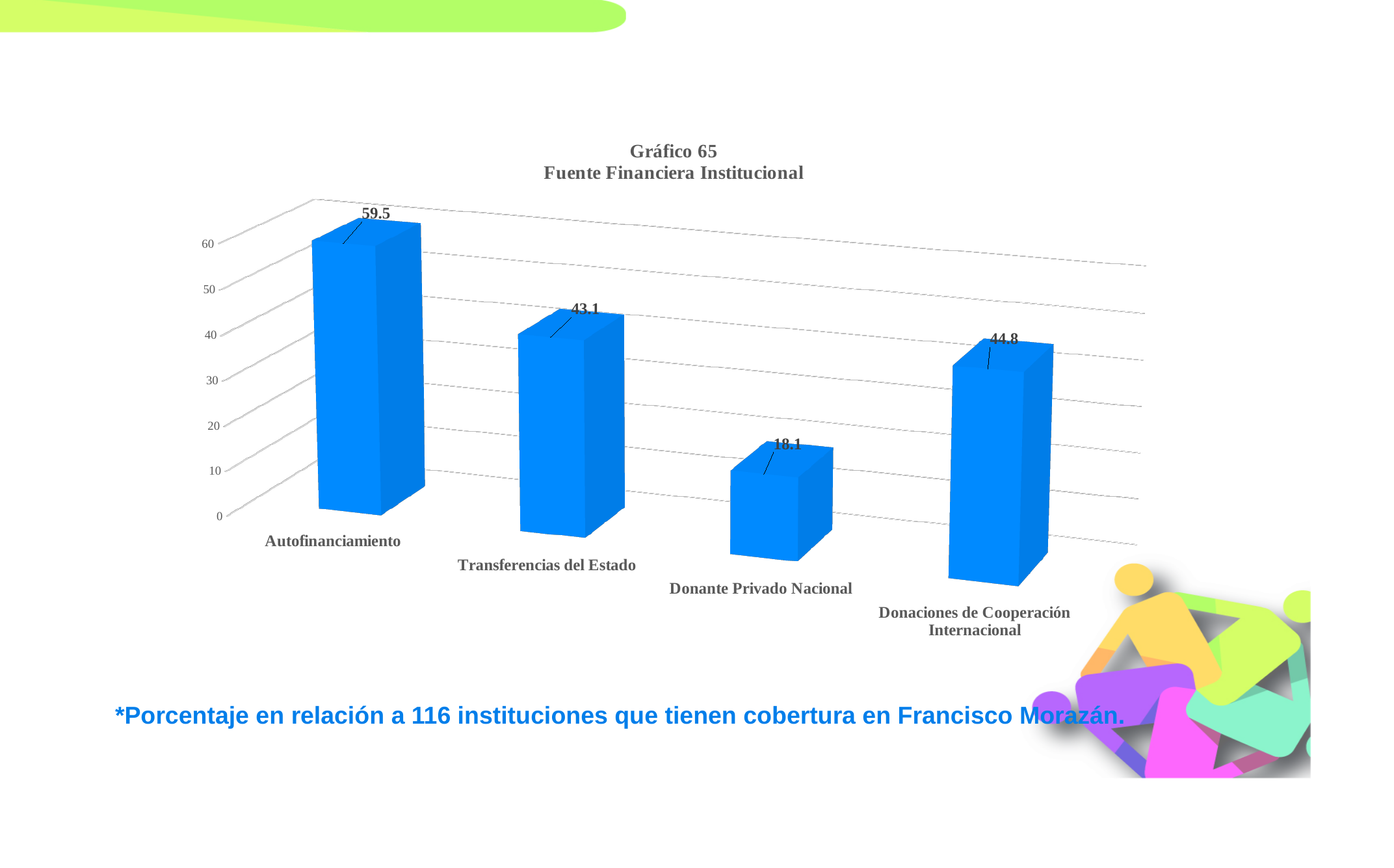
What is the title of the chart? Gráfico 65 Fuente Financiera Institucional What is the value for Donante Privado Nacional? 18.1 How many categories are shown in the chart? 4 Which category has the lowest value? Donante Privado Nacional What kind of chart is shown on the slide? Bar chart What is the value for Transferencias del Estado? 43.1 Which category has the highest value? Autofinanciamiento Which is larger, the value for Autofinanciamiento or the value for Donaciones de Cooperación Internacional? Autofinanciamiento What is the difference between the values for Donaciones de Cooperación Internacional and Transferencias del Estado? 1.7 What is the difference between the values for Autofinanciamiento and Donante Privado Nacional? 41.4 What is the value for Donaciones de Cooperación Internacional? 44.8 What is the value for Autofinanciamiento? 59.5